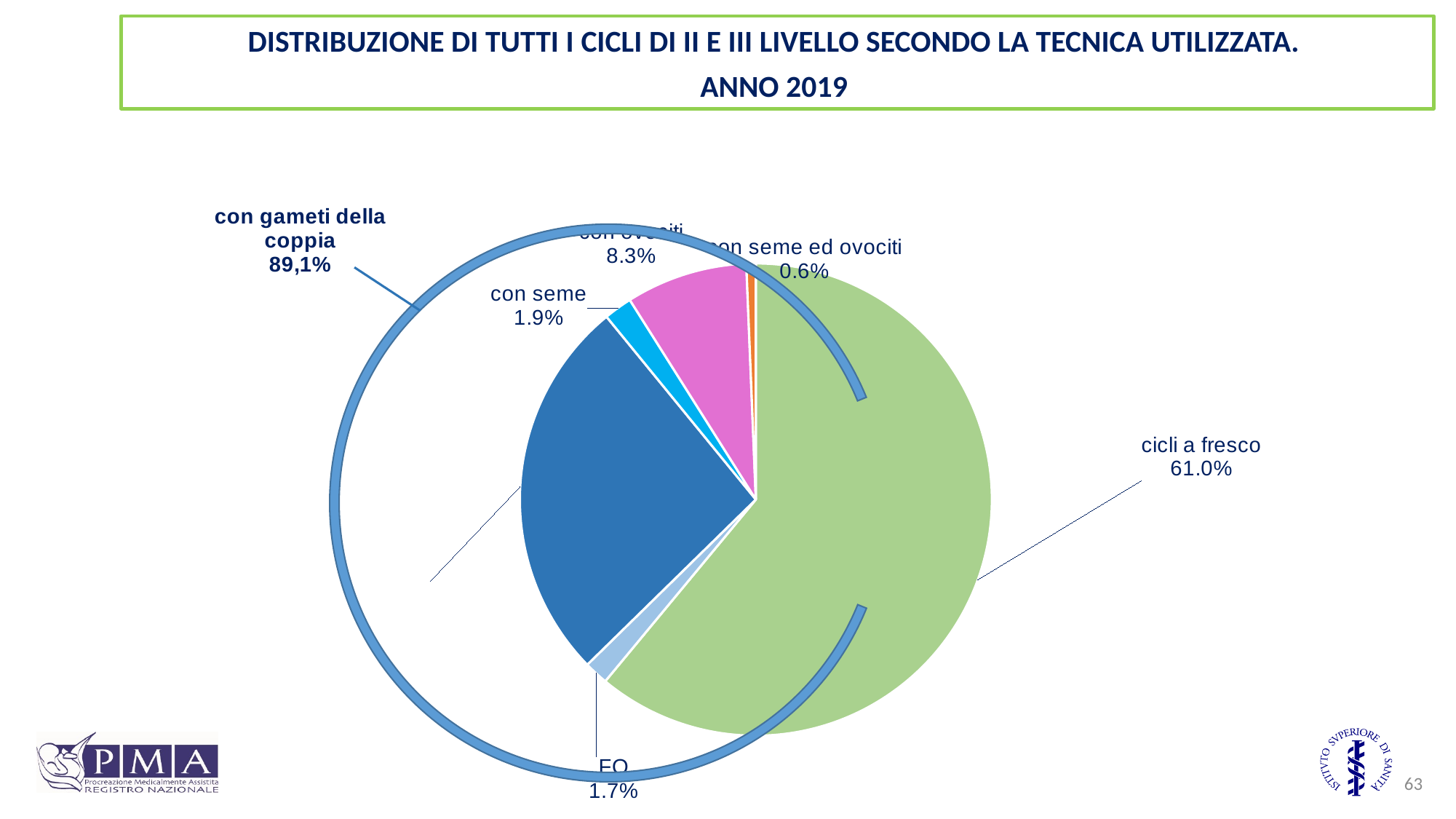
Which labelled slice of the pie is the smallest? con seme ed ovociti What percentage is shown for the "con ovociti" slice? 8.3% Which is larger, the "con seme" slice or the "FO" slice? con seme What percentage is shown for the "con seme" slice? 1.9% Which slice of the pie is the largest? cicli a fresco What percentage is given for "con gameti della coppia" in the annotation next to the pie? 89,1% How many slices does the pie chart have? 6 What is the difference in percentage points between "cicli a fresco" and "con ovociti"? 52.7% What percentage is shown for the "con seme ed ovociti" slice? 0.6% What percentage is shown for the "FO" slice? 1.7% What share of cycles is labelled "cicli a fresco"? 61.0% What kind of chart is shown on the slide? pie chart